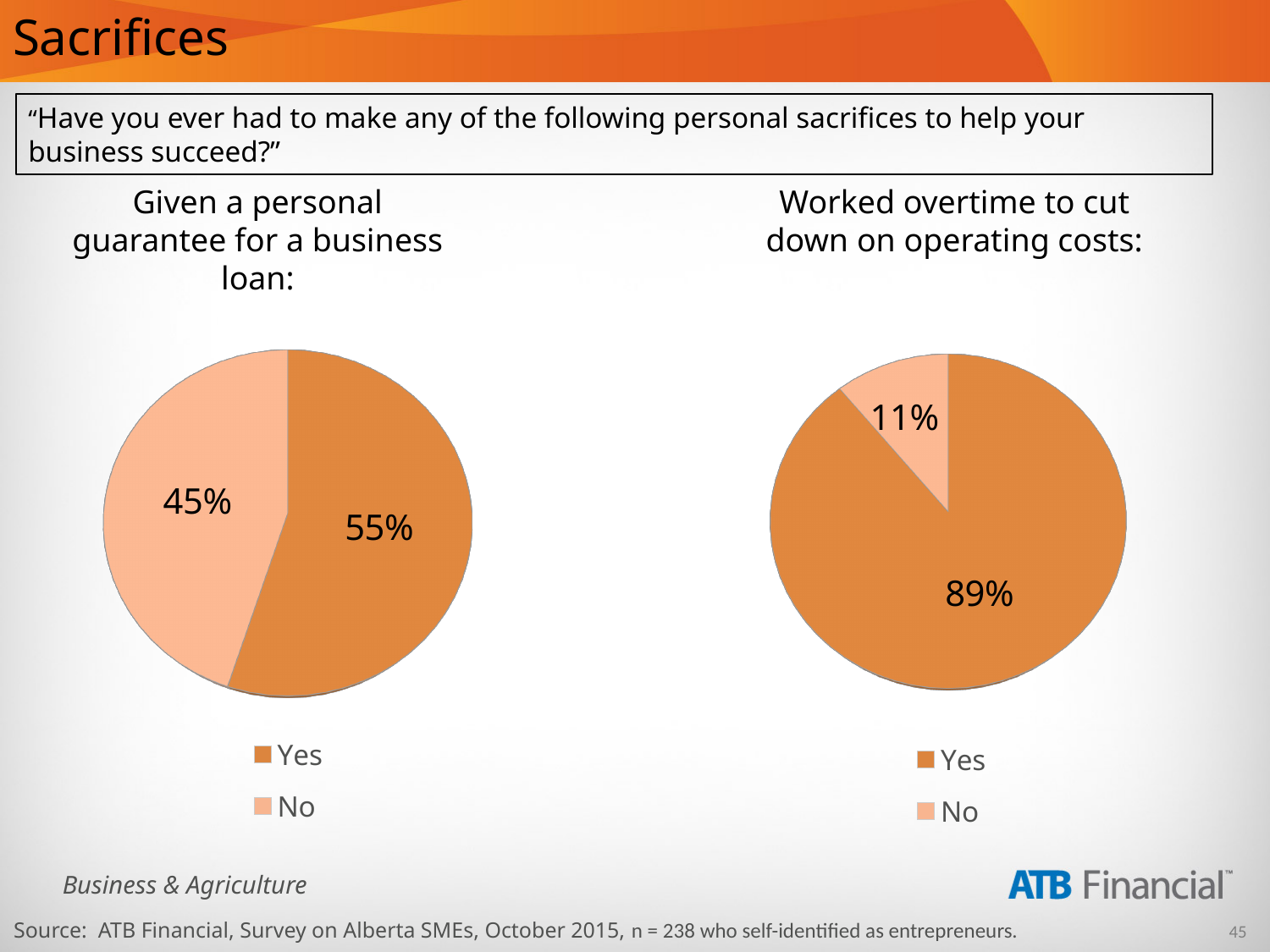
In the 'Given a personal guarantee for a business loan' chart, what is the difference between the Yes and No percentages? 10% In the 'Given a personal guarantee for a business loan' chart, what percentage answered Yes? 55% How many entries does the legend of the 'Given a personal guarantee for a business loan' chart list? 2 Which chart has the larger Yes share: 'Given a personal guarantee for a business loan' or 'Worked overtime to cut down on operating costs'? Worked overtime to cut down on operating costs In the 'Given a personal guarantee for a business loan' chart, what percentage answered No? 45% How many slices does the 'Worked overtime to cut down on operating costs' chart have? 2 In the 'Worked overtime to cut down on operating costs' chart, which response has the largest slice? Yes In the 'Worked overtime to cut down on operating costs' chart, what is the difference between the Yes and No percentages? 78% In the 'Given a personal guarantee for a business loan' chart, which response has the smallest slice? No In the 'Worked overtime to cut down on operating costs' chart, what percentage answered Yes? 89% What type of chart is used on the left side of the slide? Pie chart In the 'Worked overtime to cut down on operating costs' chart, what percentage answered No? 11%